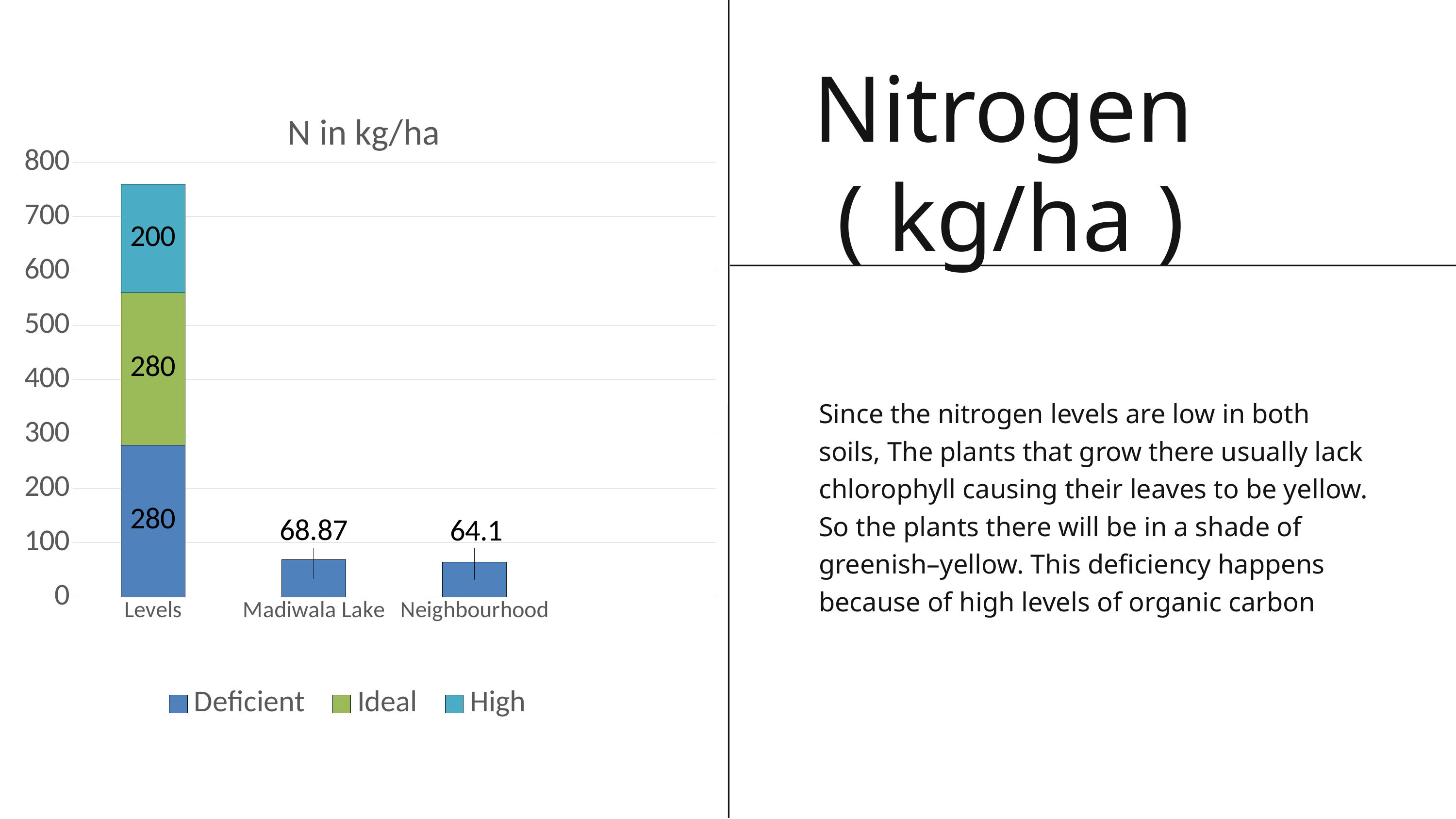
How many categories are shown on the x axis of the chart? 3 Which is larger, the value for Madiwala Lake or the value for Neighbourhood? Madiwala Lake How many series does the chart legend list? 3 What kind of chart is shown on the slide? stacked bar chart What is the High value in the Levels bar? 200 What is the title of the chart? N in kg/ha Which category has the tallest bar? Levels What is the total of the stacked Levels bar? 760 What is the difference between the Madiwala Lake value and the Neighbourhood value? 4.77 What is the Ideal value in the Levels bar? 280 What is the value for Neighbourhood? 64.1 What is the value for Madiwala Lake? 68.87